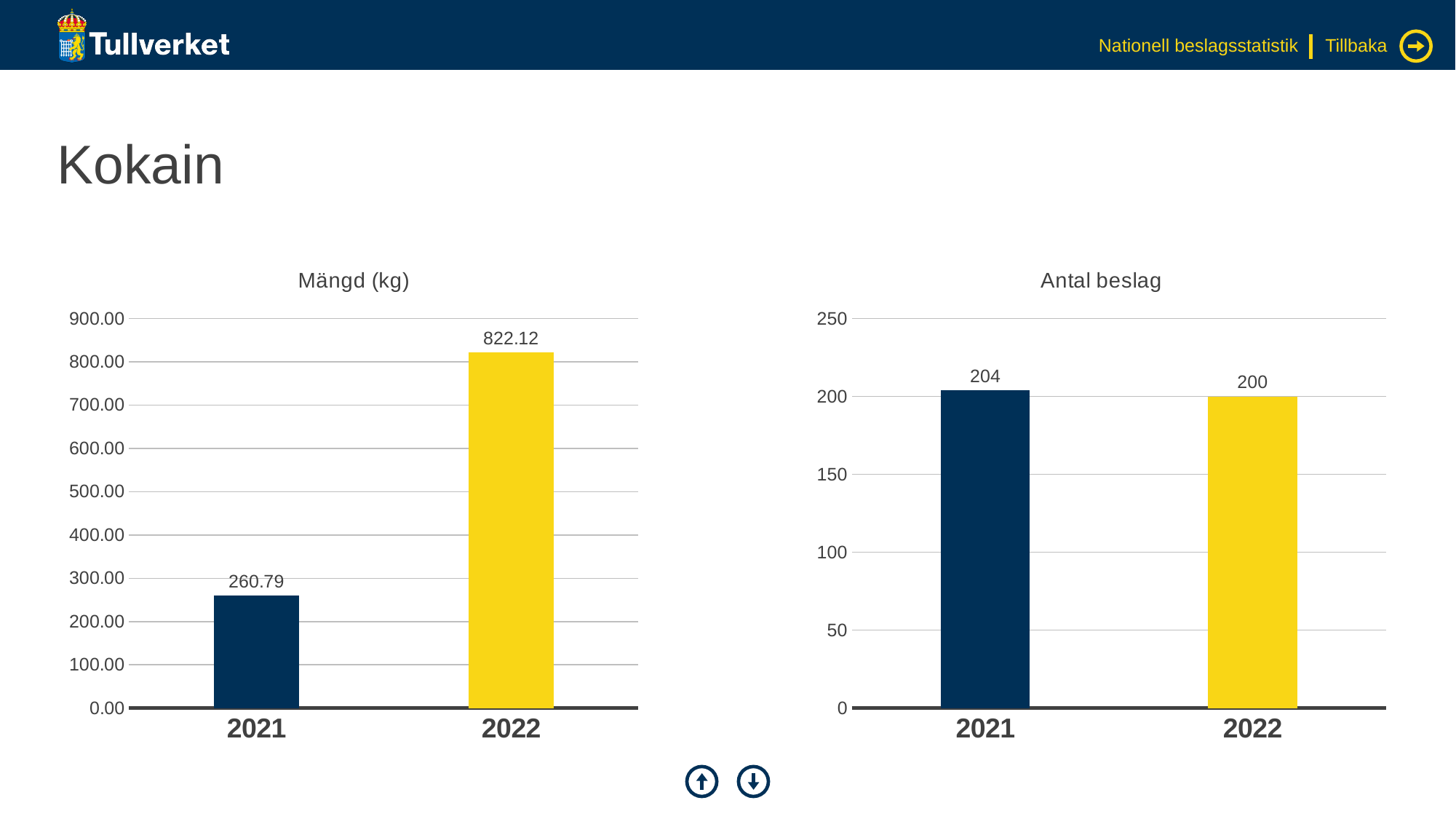
In the 'Mängd (kg)' chart, is the value for 2021 greater or less than 300.00? less In the 'Mängd (kg)' chart, what is the value for 2022? 822.12 In the 'Antal beslag' chart, which year has the lowest value? 2022 In the 'Antal beslag' chart, what is the difference between the 2021 and 2022 values? 4 In the 'Mängd (kg)' chart, what is the value for 2021? 260.79 What kind of chart is the 'Mängd (kg)' chart? bar chart In the 'Mängd (kg)' chart, which year has the highest value? 2022 In the 'Mängd (kg)' chart, what is the difference between the 2022 and 2021 values? 561.33 In the 'Antal beslag' chart, what is the value for 2022? 200 What is the title of the chart on the right side of the slide? Antal beslag How many categories are shown in the 'Antal beslag' chart? 2 In the 'Antal beslag' chart, what is the value for 2021? 204